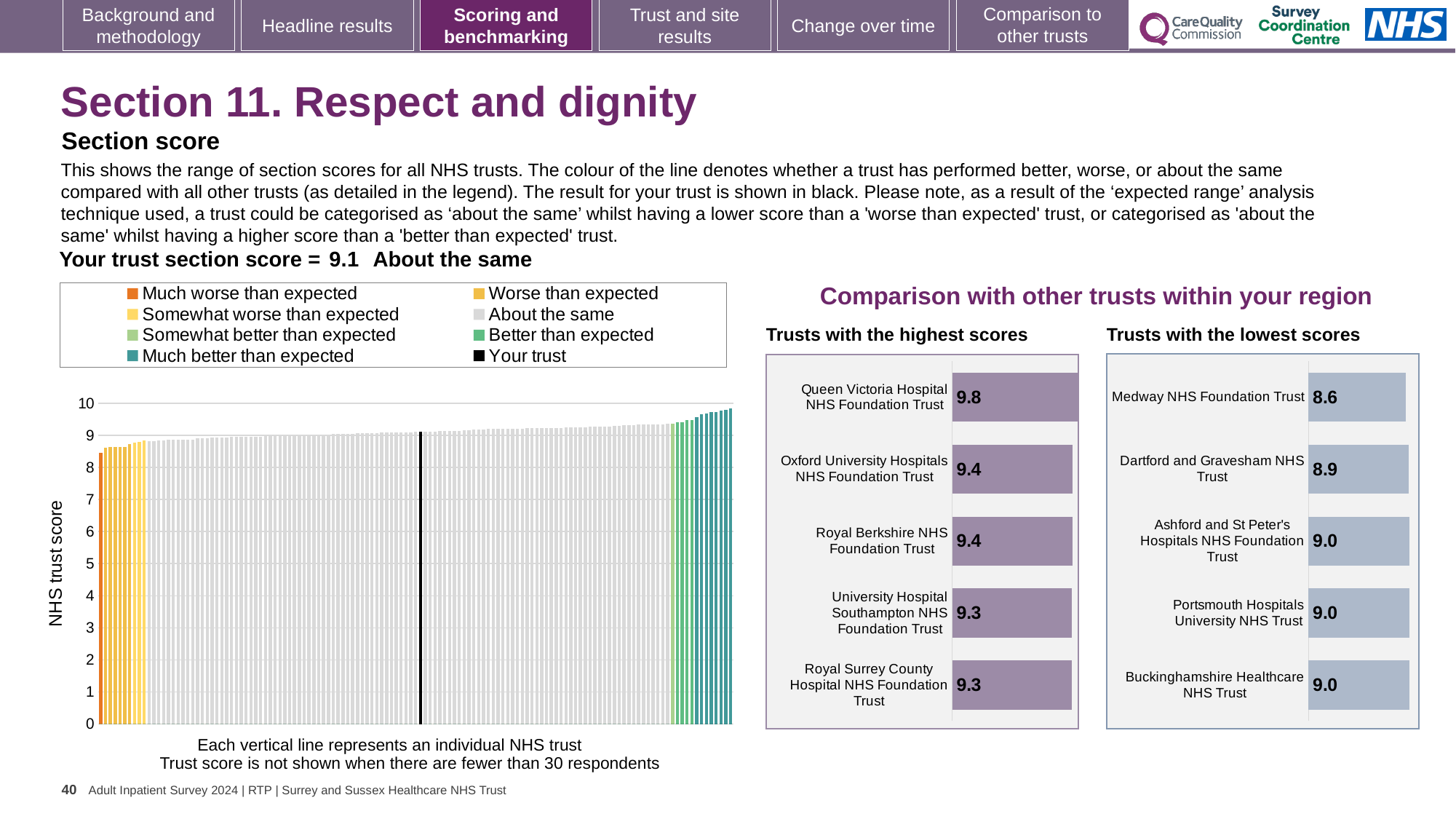
How many trusts are shown in the 'Trusts with the highest scores' chart? 5 In the NHS trust score chart on the left, do the values rise or fall from left to right? Rise How many entries does the legend of the NHS trust score chart on the left list? 8 In the NHS trust score chart on the left, is the value of the leftmost bar greater or less than 8? greater In the 'Trusts with the lowest scores' chart, how much higher is the score of Dartford and Gravesham NHS Trust than that of Medway NHS Foundation Trust? 0.3 In the 'Trusts with the highest scores' chart, which trust has the highest score? Queen Victoria Hospital NHS Foundation Trust In the 'Trusts with the highest scores' chart, which has the higher score: Oxford University Hospitals NHS Foundation Trust or University Hospital Southampton NHS Foundation Trust? Oxford University Hospitals NHS Foundation Trust In the 'Trusts with the lowest scores' chart, what is the score for Medway NHS Foundation Trust? 8.6 In the 'Trusts with the lowest scores' chart, which trust has the lowest score? Medway NHS Foundation Trust In the 'Trusts with the highest scores' chart, what is the difference between the scores of Queen Victoria Hospital NHS Foundation Trust and Royal Surrey County Hospital NHS Foundation Trust? 0.5 What kind of chart is the NHS trust score chart on the left of the slide? Bar chart In the 'Trusts with the highest scores' chart, what is the score for Queen Victoria Hospital NHS Foundation Trust? 9.8